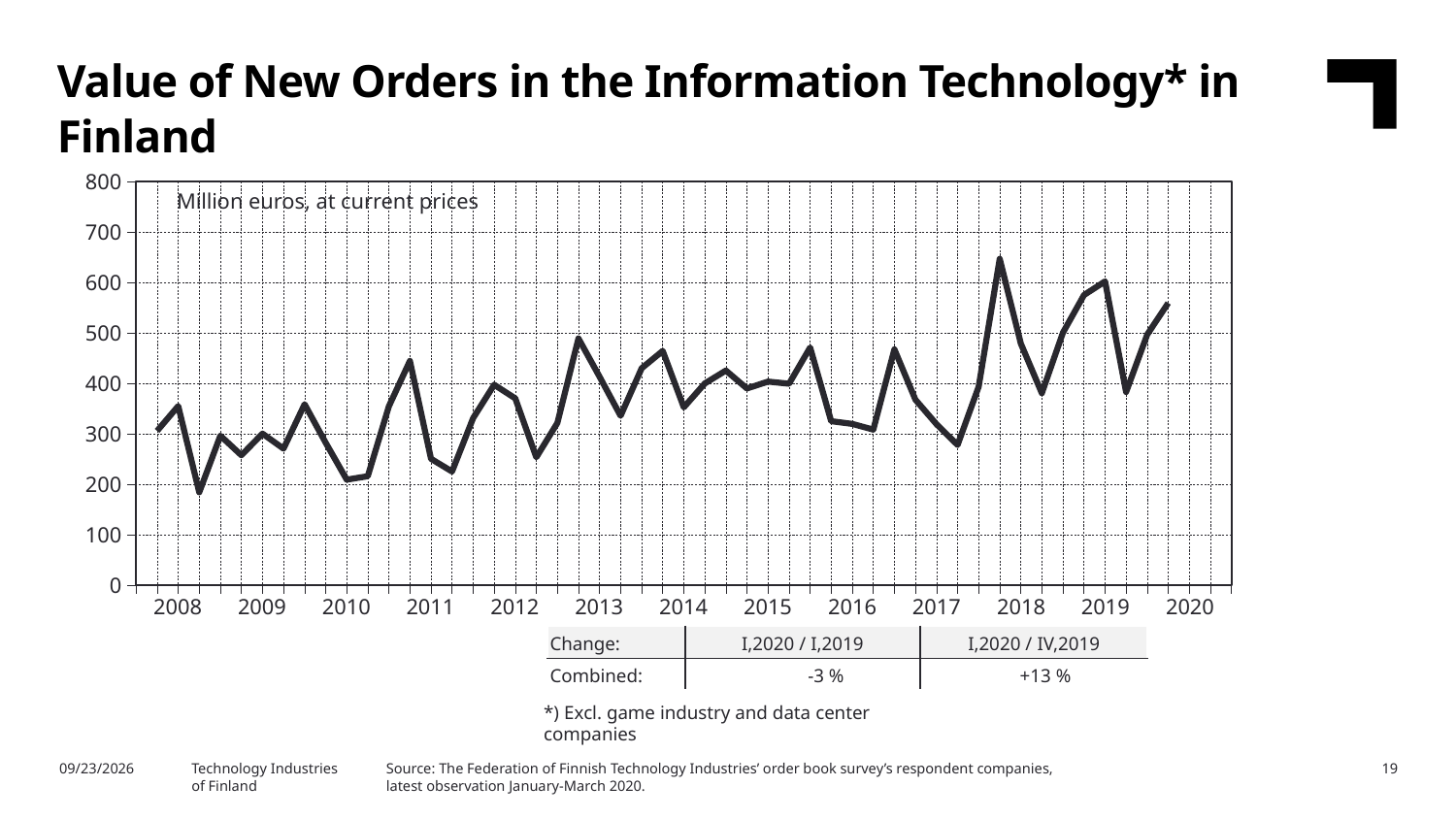
What is the title of the chart? Value of New Orders in the Information Technology* in Finland Is the peak value in 2011 greater or less than 400? greater Is the lowest point of the line, in 2008, greater or less than 200? less In what unit are the values on the chart expressed, according to the label inside the plot area? Million euros, at current prices What kind of chart is shown on the slide? line chart According to the change table below the chart, what is the combined change for I,2020 / IV,2019? +13 % Is the highest peak of the line, around 2018, greater or less than 600? greater In which year does the line reach its lowest point? 2008 In which year does the line reach its highest peak? 2018 Overall, does the value of new orders rise or fall from 2008 to 2020? rise How many year labels are shown on the x axis? 13